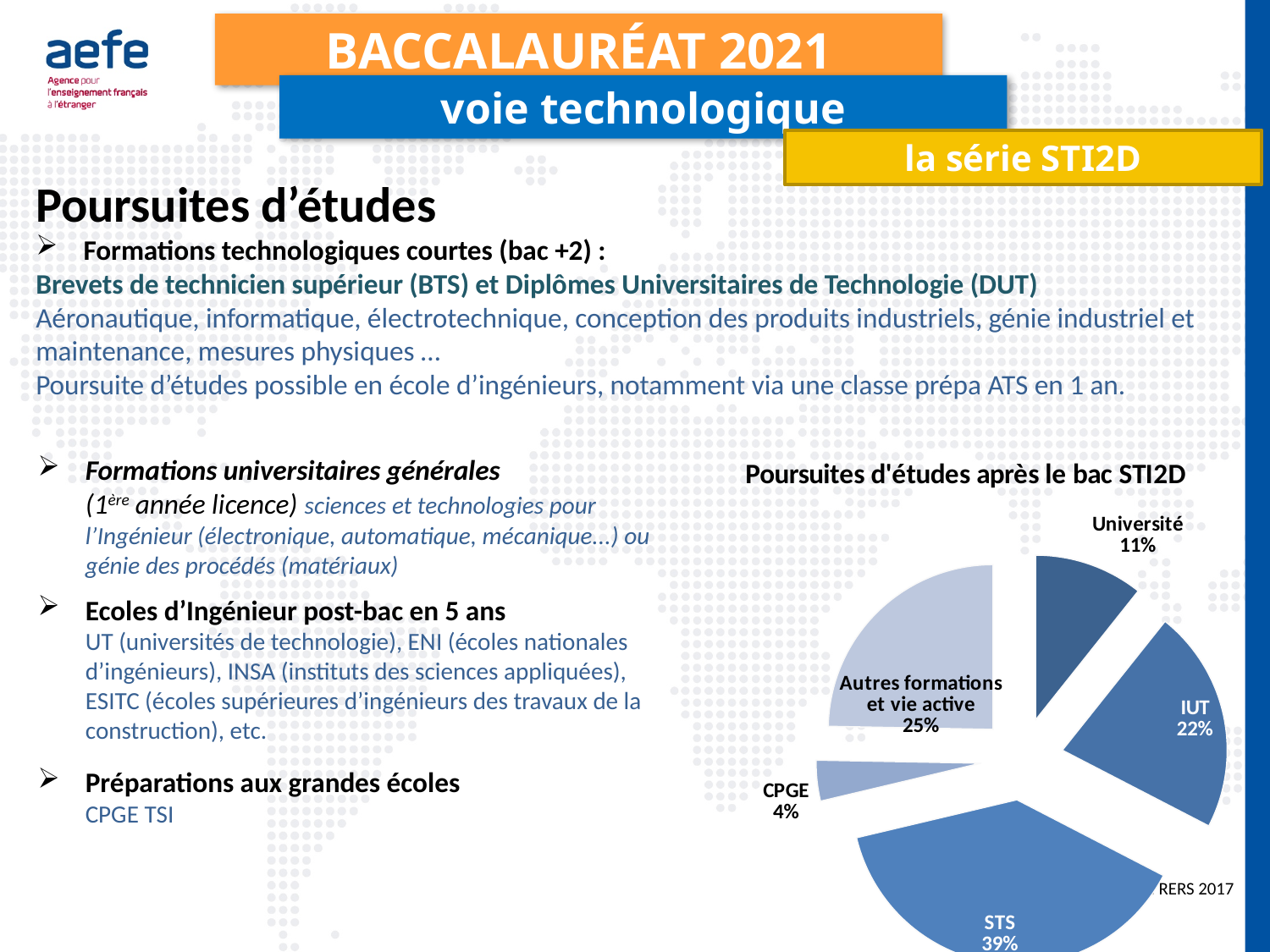
What share of the pie does Autres formations et vie active represent? 25% What is the title of the pie chart? Poursuites d'études après le bac STI2D Which category has the largest slice of the pie? STS What share of the pie does CPGE represent? 4% What share of the pie does Université represent? 11% What is the difference between the STS share and the IUT share? 17% What share of the pie does STS represent? 39% Which category has the smallest slice of the pie? CPGE Which is larger, the share for IUT or the share for Université? IUT How many categories are shown in the pie chart? 5 What kind of chart is shown on the slide? pie chart What share of the pie does IUT represent? 22%